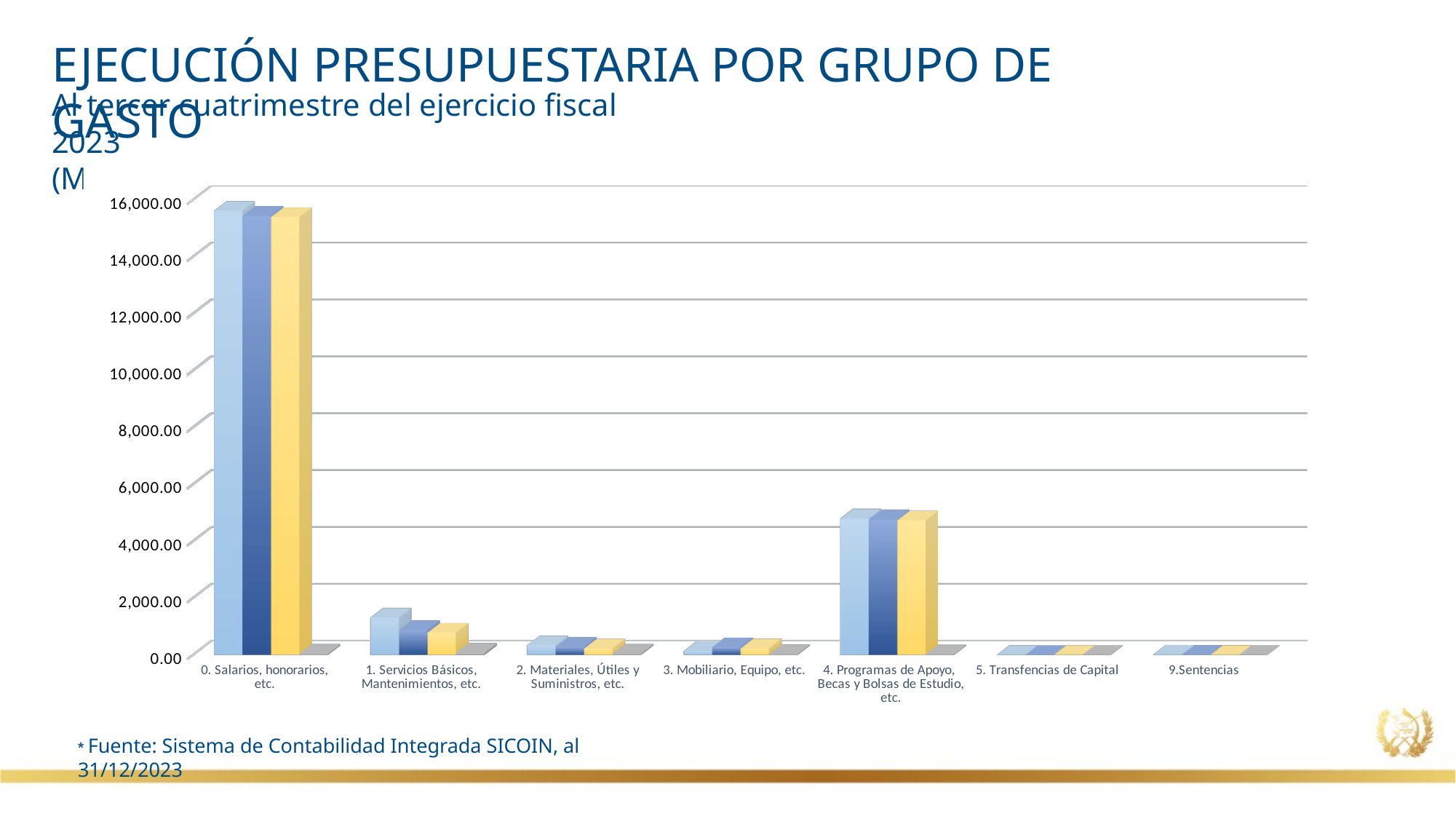
How many expense group categories are shown on the x axis of the chart? 7 What kind of chart is shown on the slide? Bar chart Is the value for 4. Programas de Apoyo, Becas y Bolsas de Estudio, etc. greater or less than 6,000.00? less Is the value for 1. Servicios Básicos, Mantenimientos, etc. greater or less than 2,000.00? less Is the value for 0. Salarios, honorarios, etc. greater or less than 14,000.00? greater Which is larger, the value for 0. Salarios, honorarios, etc. or for 4. Programas de Apoyo, Becas y Bolsas de Estudio, etc.? 0. Salarios, honorarios, etc. How many bars are plotted for each category in the chart? 4 Which category has the highest bars in the chart? 0. Salarios, honorarios, etc. Which is larger, the value for 1. Servicios Básicos, Mantenimientos, etc. or for 2. Materiales, Útiles y Suministros, etc.? 1. Servicios Básicos, Mantenimientos, etc. What is the highest value shown on the vertical axis of the chart? 16,000.00